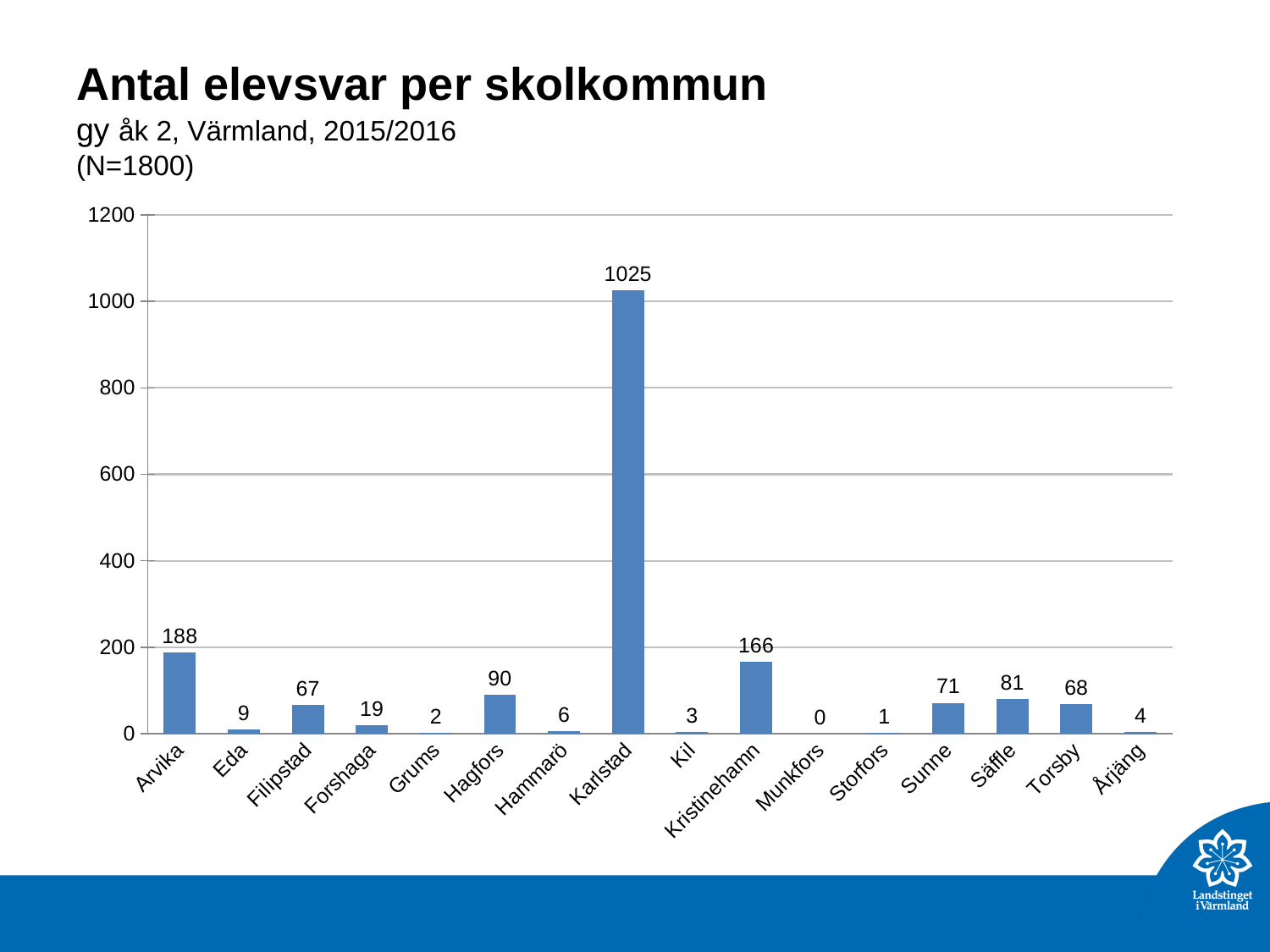
What kind of chart is shown on the slide? bar chart What is the total N stated in the subtitle? 1800 Which is larger, the value for Säffle or the value for Sunne? Säffle What is the value for Kristinehamn? 166 How many municipalities are shown on the x axis? 16 Which municipality has the highest number of responses? Karlstad What is the difference between the values for Arvika and Kristinehamn? 22 What is the title of the chart? Antal elevsvar per skolkommun Is the value for Karlstad greater or less than 1000? greater What is the value for Karlstad? 1025 What is the value for Hagfors? 90 Which municipality has the lowest number of responses? Munkfors